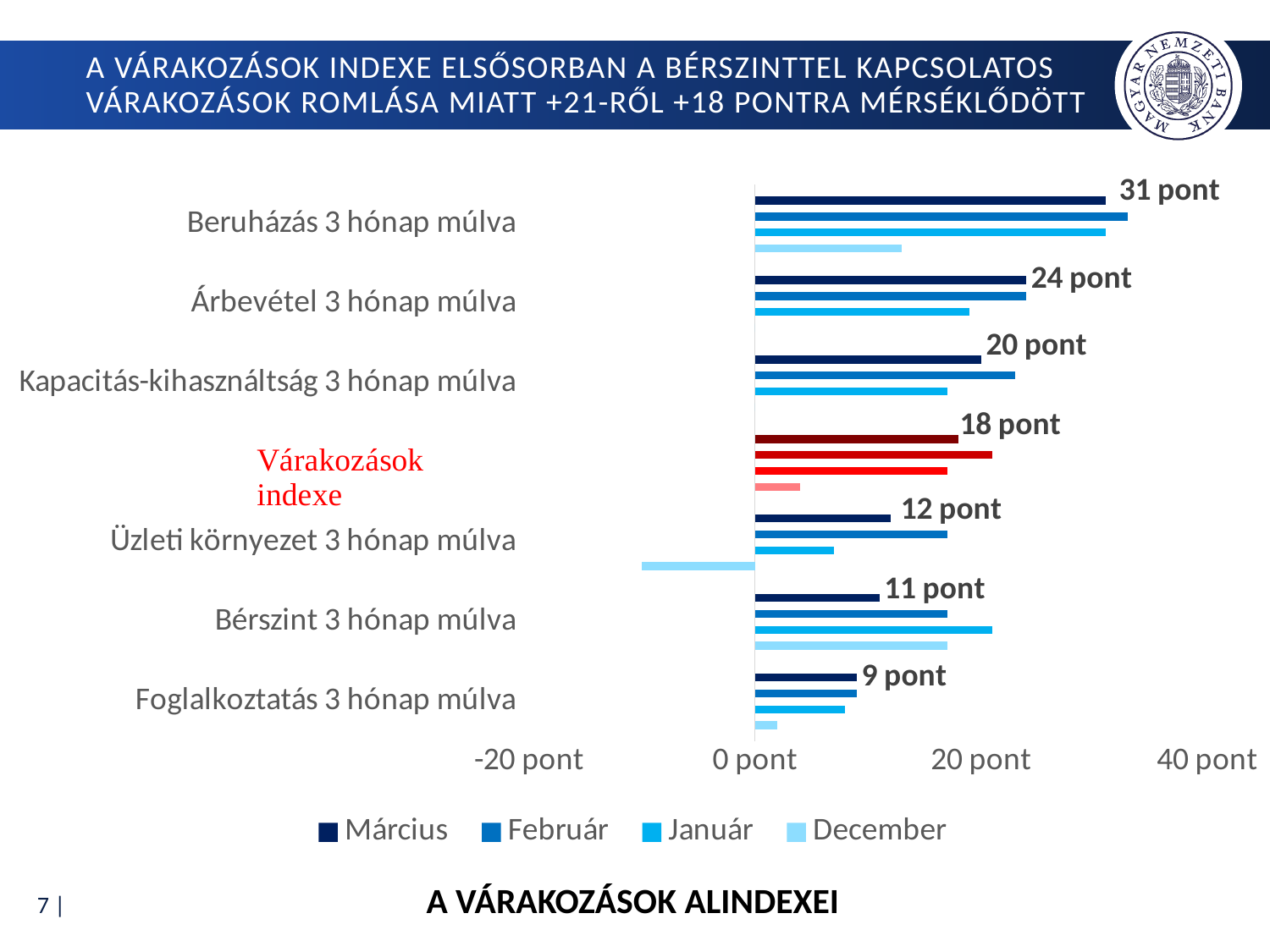
Which category has the lowest Március value? Foglalkoztatás 3 hónap múlva Is the Február value for Beruházás 3 hónap múlva greater or less than 20 pont? greater Is the December value for Üzleti környezet 3 hónap múlva greater or less than 0 pont? less Which has the larger Március value, Árbevétel 3 hónap múlva or Kapacitás-kihasználtság 3 hónap múlva? Árbevétel 3 hónap múlva What is the Március value for Beruházás 3 hónap múlva? 31 pont What is the Március value for Foglalkoztatás 3 hónap múlva? 9 pont What kind of chart is shown on the slide? bar chart What is the difference between the Március values for Beruházás 3 hónap múlva and Foglalkoztatás 3 hónap múlva? 22 pont What is the Március value for Várakozások indexe? 18 pont How many series does the legend list? 4 How many categories are shown on the chart? 7 Which category has the highest Március value? Beruházás 3 hónap múlva